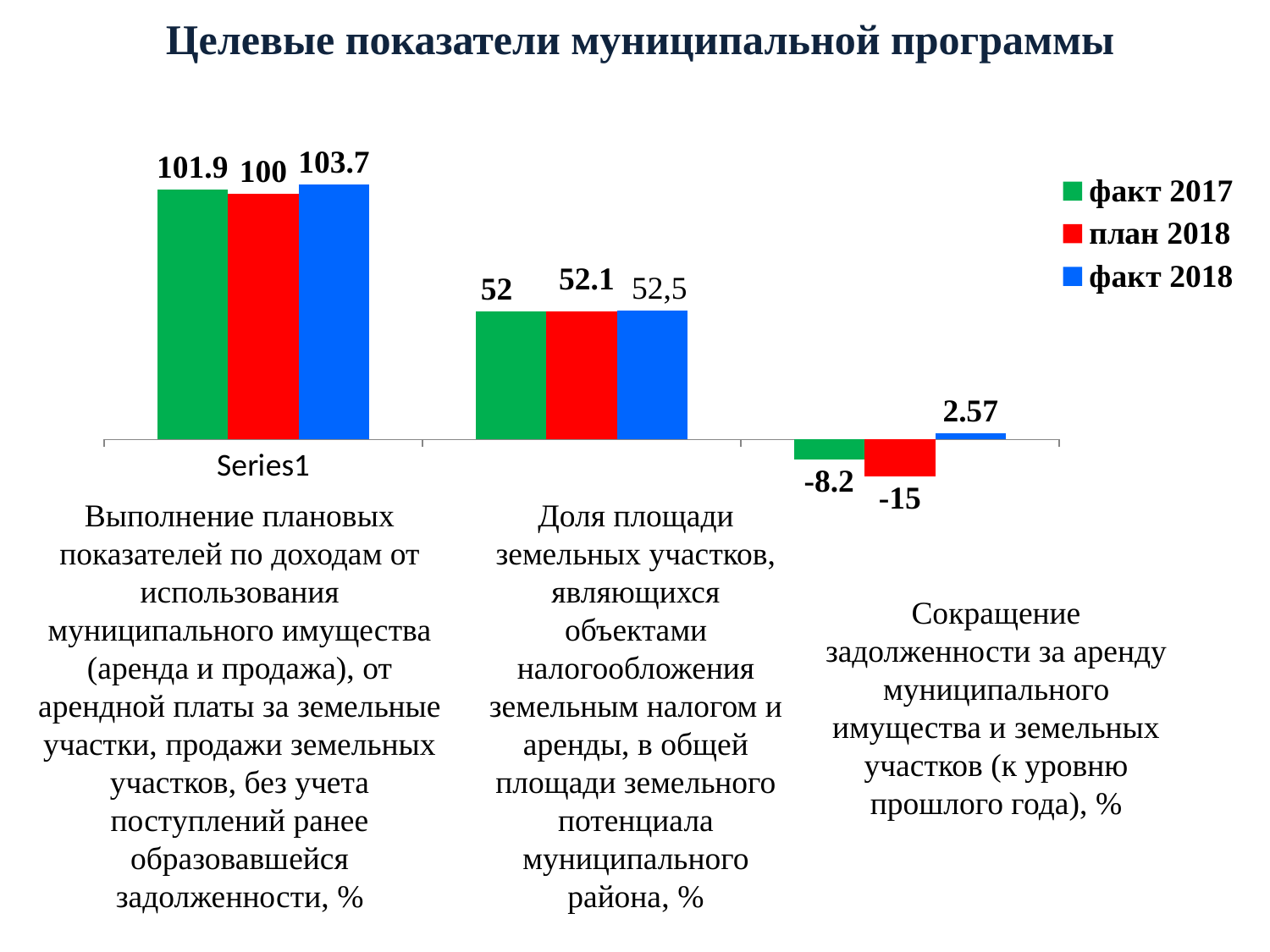
What is the план 2018 value for the third group of bars (Сокращение задолженности за аренду...)? -15 What is the факт 2017 value for the second group of bars (Доля площади земельных участков...)? 52 What is the факт 2018 value for the first group of bars (Выполнение плановых показателей по доходам...)? 103.7 Which series has the highest value in the first group of bars (Выполнение плановых показателей по доходам...)? факт 2018 In the third group of bars (Сокращение задолженности за аренду...), which is larger: the факт 2017 value or the план 2018 value? факт 2017 What are the legend entries of the chart? факт 2017, план 2018, факт 2018 What is the план 2018 value for the first group of bars (Выполнение плановых показателей по доходам...)? 100 What is the факт 2018 value for the third group of bars (Сокращение задолженности за аренду...)? 2.57 What is the difference between the факт 2018 and план 2018 values in the first group of bars (Выполнение плановых показателей по доходам...)? 3.7 Which series has the lowest value in the third group of bars (Сокращение задолженности за аренду...)? план 2018 How many series does the legend list? 3 What kind of chart is shown on the slide? bar chart